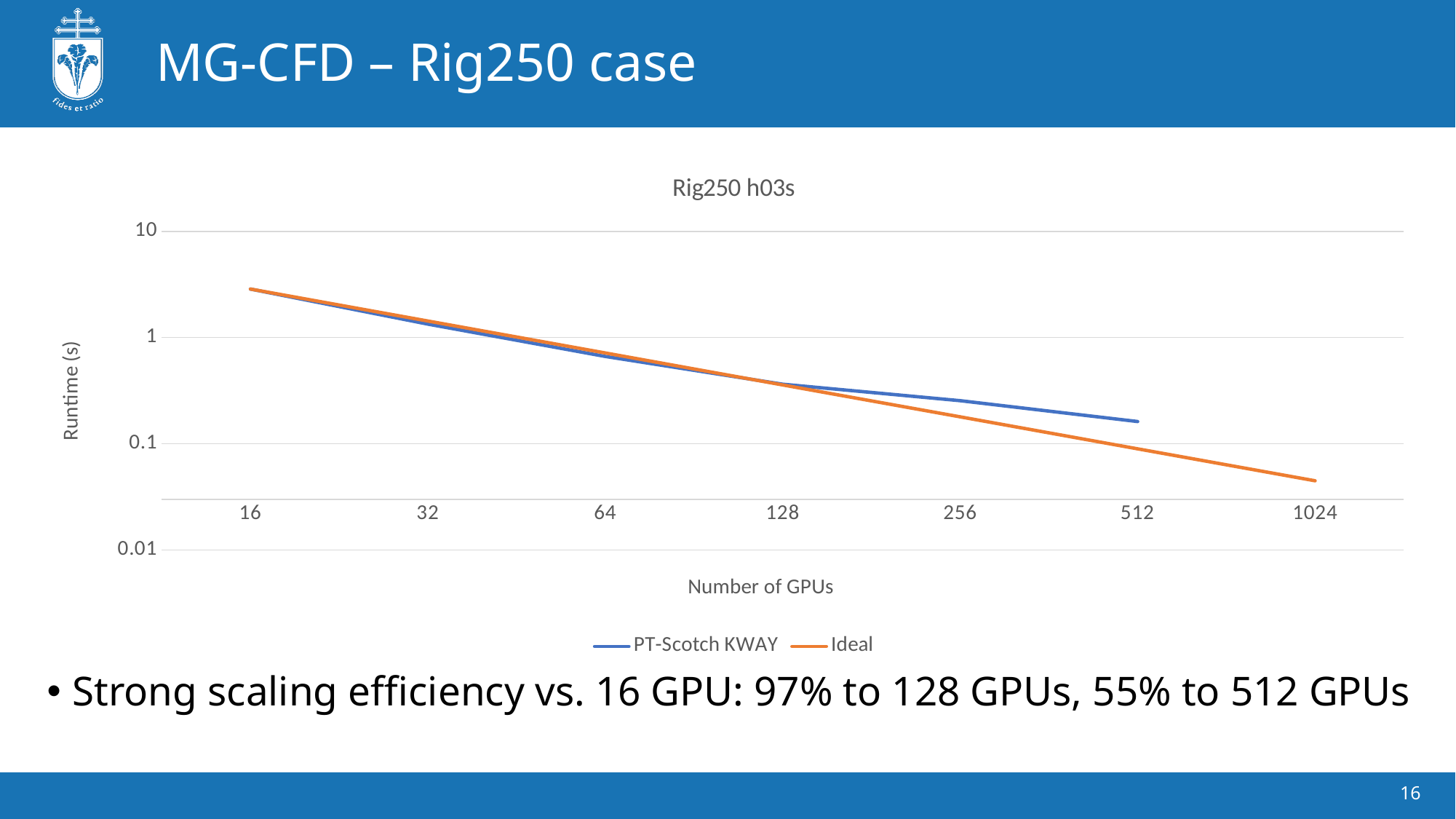
Is the Ideal runtime at 1024 GPUs greater or less than 0.1? less How many tick labels are shown on the x axis (Number of GPUs)? 7 Is the Ideal runtime at 128 GPUs greater or less than 1? less Is the PT-Scotch KWAY runtime at 16 GPUs greater or less than 1? greater At what number of GPUs does the PT-Scotch KWAY line end? 512 How many series does the legend list? 2 At 512 GPUs, which series has the higher runtime, PT-Scotch KWAY or Ideal? PT-Scotch KWAY What is the label of the y axis? Runtime (s) What kind of chart is shown on the slide? Line chart Does the runtime for PT-Scotch KWAY rise or fall as the number of GPUs increases? Fall What is the title of the chart? Rig250 h03s